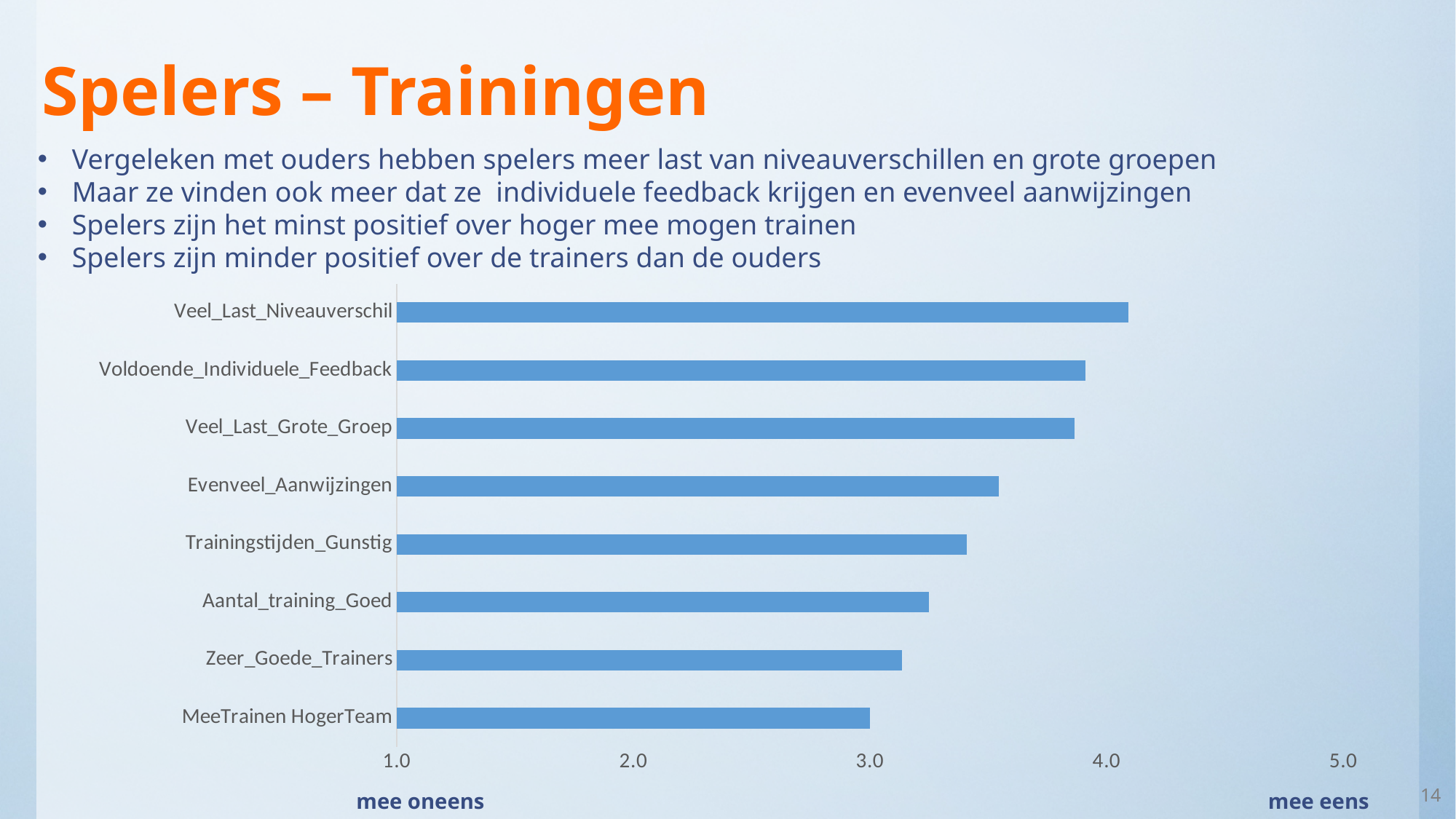
Which is larger, the value for Veel_Last_Niveauverschil or the value for Zeer_Goede_Trainers? Veel_Last_Niveauverschil Is the value for Evenveel_Aanwijzingen greater or less than 3.0? greater Which category has the lowest value in the chart? MeeTrainen HogerTeam What label appears at the right end of the horizontal axis, under 5.0? mee eens How many categories are plotted in the chart? 8 Which category has the highest value in the chart? Veel_Last_Niveauverschil Do the bar values increase or decrease going from the top category to the bottom category? decrease What kind of chart is shown on the slide? bar chart Is the value for Veel_Last_Niveauverschil greater or less than 4.0? greater Is the value for Trainingstijden_Gunstig greater or less than 4.0? less Which is larger, the value for Voldoende_Individuele_Feedback or the value for MeeTrainen HogerTeam? Voldoende_Individuele_Feedback